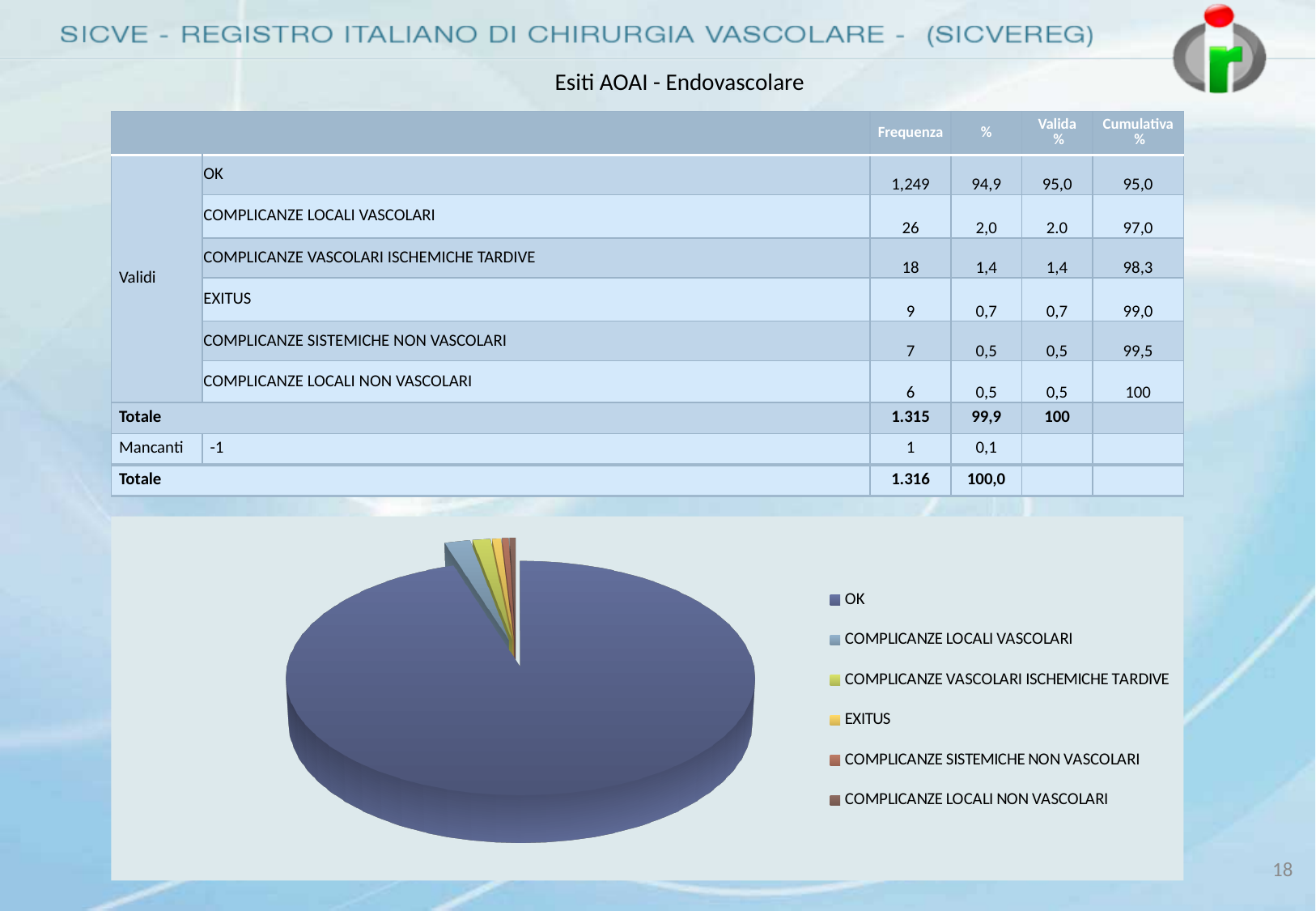
Where is the legend placed relative to the pie chart? to the right of the pie What colour is the OK slice in the pie chart? dark blue According to the table, what is the % value for EXITUS? 0,7 According to the table, what is the Frequenza for OK? 1,249 Which slice is larger in the pie chart, OK or COMPLICANZE LOCALI VASCOLARI? OK According to the table, what is the Frequenza of the Totale row for the Validi categories? 1.315 Which category has the largest slice in the pie chart? OK What kind of chart is shown at the bottom of the slide? pie chart According to the table, what is the difference in Frequenza between COMPLICANZE LOCALI VASCOLARI and COMPLICANZE VASCOLARI ISCHEMICHE TARDIVE? 8 According to the table, what is the Cumulativa % for COMPLICANZE LOCALI VASCOLARI? 97,0 Does the OK slice take up more or less than half of the pie? more How many entries does the legend of the pie chart list? 6